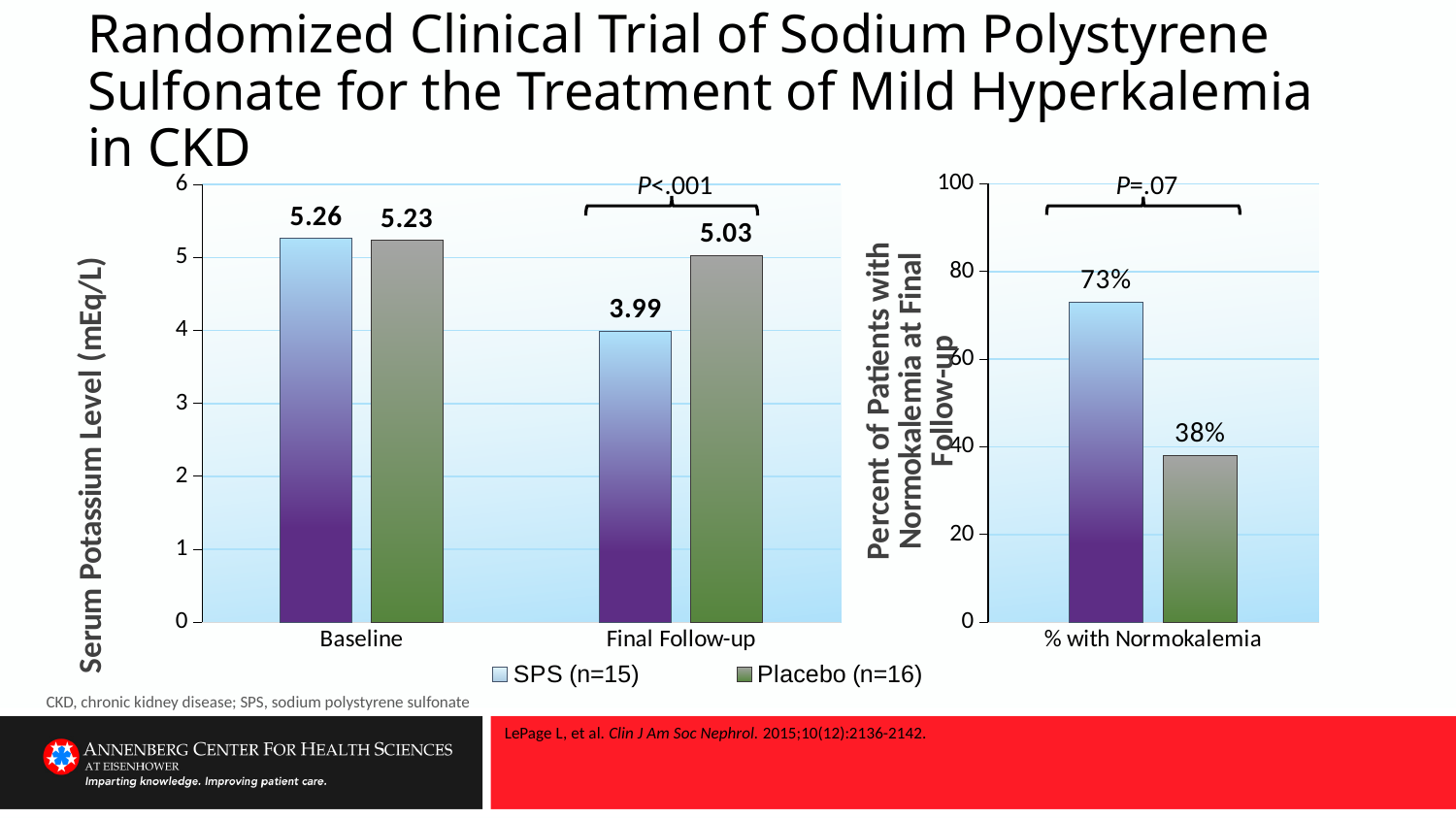
In the right chart (Percent of Patients with Normokalemia), what is the value for SPS? 73% What kind of chart is the left chart (Serum Potassium Level)? Bar chart In the right chart (Percent of Patients with Normokalemia), what is the difference between the SPS and Placebo values? 35% In the left chart (Serum Potassium Level), how many categories are shown on the x axis? 2 In the left chart (Serum Potassium Level), what is the value for SPS at Baseline? 5.26 In the left chart (Serum Potassium Level), what is the difference between the Placebo and SPS values at Final Follow-up? 1.04 In the left chart (Serum Potassium Level), what is the value for SPS at Final Follow-up? 3.99 In the left chart (Serum Potassium Level), how many series does the legend list? 2 In the left chart (Serum Potassium Level), which bar has the lowest value? SPS at Final Follow-up In the right chart (Percent of Patients with Normokalemia), which group has the higher value, SPS or Placebo? SPS In the right chart (Percent of Patients with Normokalemia), what is the value for Placebo? 38% In the left chart (Serum Potassium Level), what is the value for Placebo at Final Follow-up? 5.03